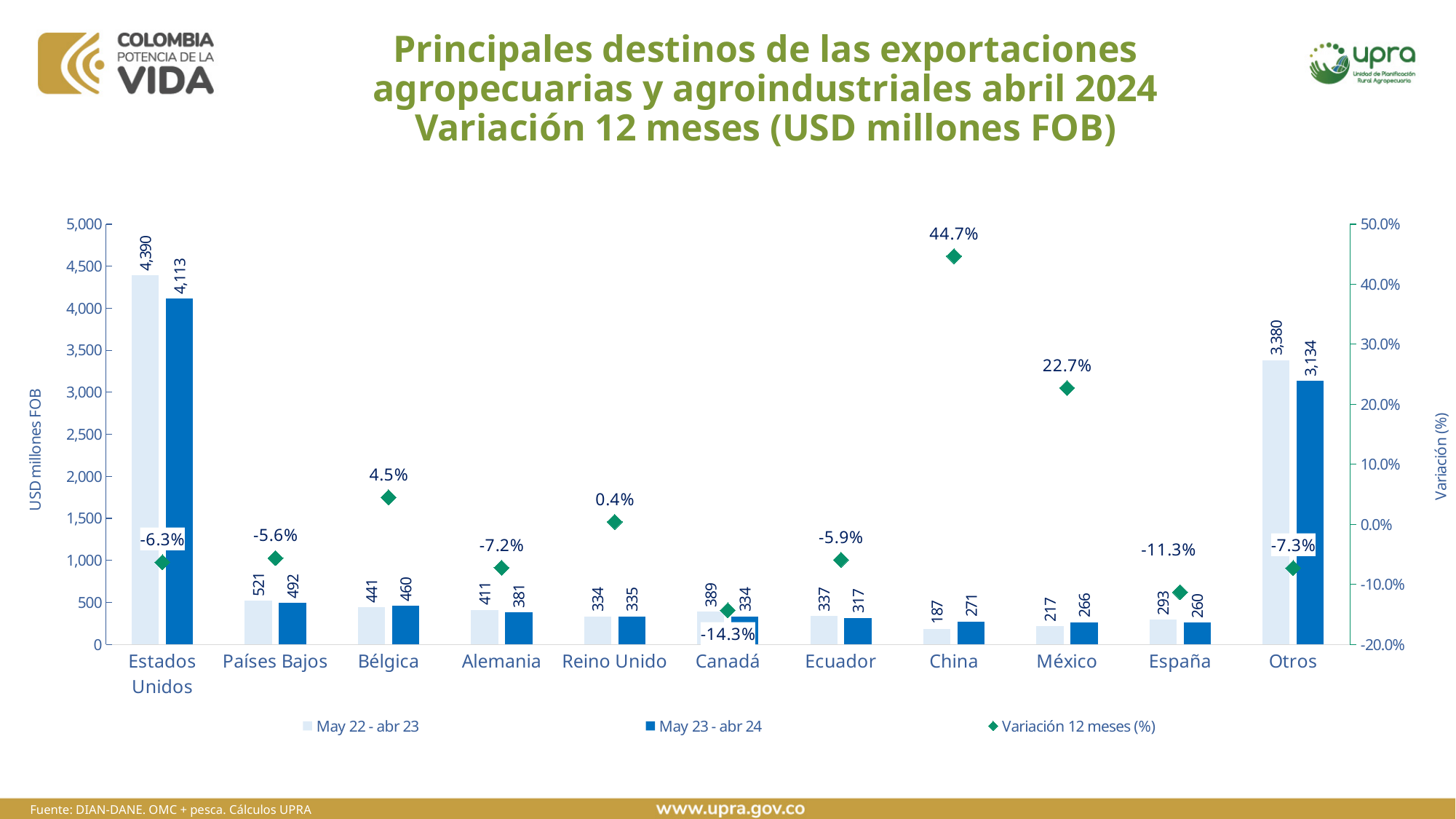
Which country has the highest 12-month variation (Variación 12 meses)? China What is the value for Estados Unidos in the May 23 - abr 24 series? 4,113 What is the 12-month variation (Variación 12 meses) shown for China? 44.7% What is the label of the left vertical axis? USD millones FOB Which is larger for México: the May 22 - abr 23 value or the May 23 - abr 24 value? May 23 - abr 24 Excluding Otros, which destination has the lowest value in the May 22 - abr 23 series? China What is the difference between the May 22 - abr 23 and May 23 - abr 24 values for Estados Unidos? 277 What is the difference between the May 23 - abr 24 values for Otros and Estados Unidos? 979 What is the value for Canadá in the May 22 - abr 23 series? 389 Which country has the lowest 12-month variation (Variación 12 meses)? Canadá How many destination categories are shown on the x axis? 11 How many series does the legend list? 3